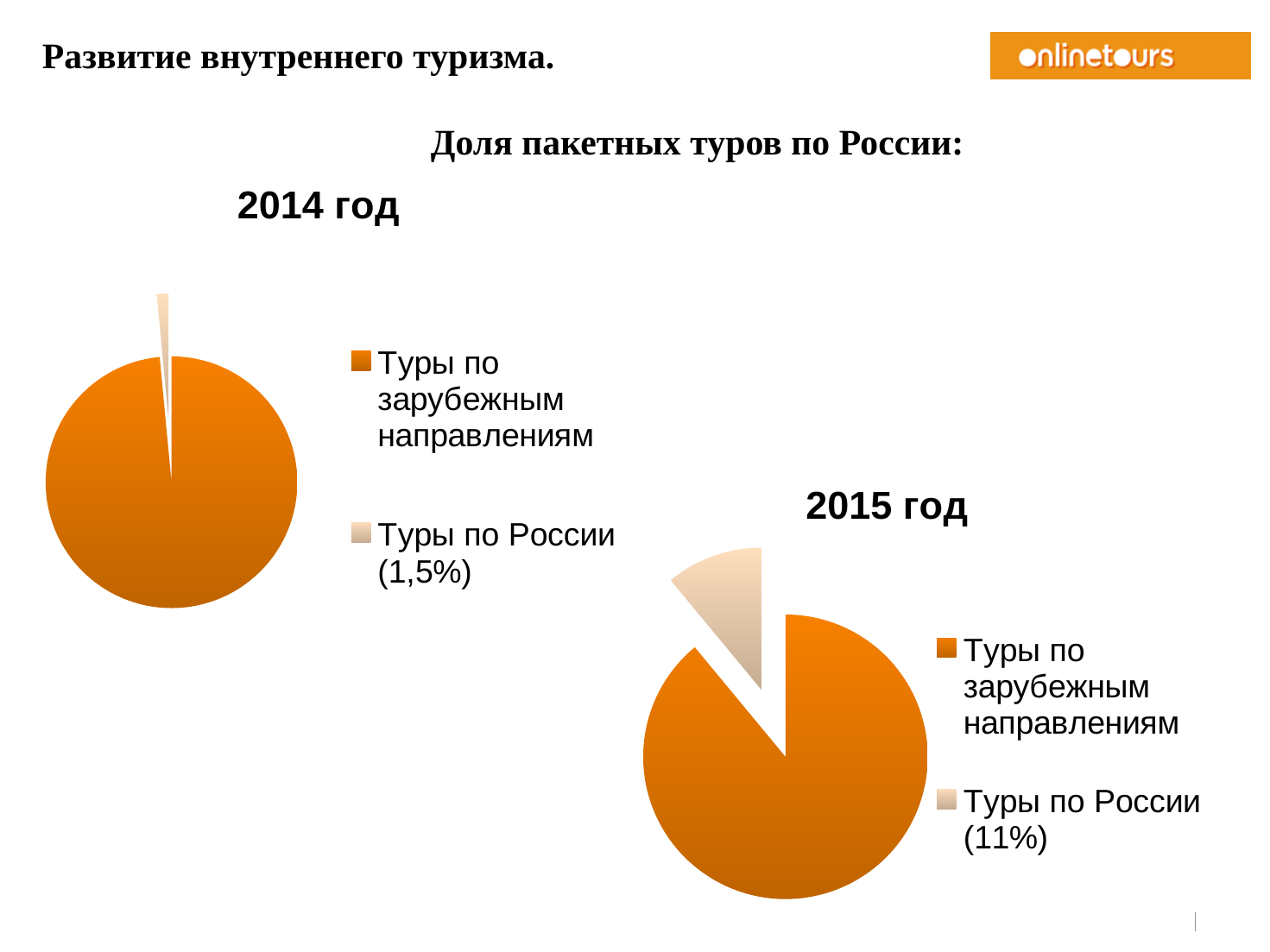
In the "2015 год" chart, which category has the smallest slice? Туры по России How many entries does the legend of the "2015 год" chart list? 2 How many slices does the "2014 год" pie chart have? 2 In the "2015 год" chart, what colour is the "Туры по зарубежным направлениям" slice? orange Did the share of "Туры по России" rise or fall from the 2014 chart to the 2015 chart? rise In the "2014 год" chart, which category has the largest slice? Туры по зарубежным направлениям By how many percentage points did the share of "Туры по России" change from the "2014 год" chart to the "2015 год" chart? 9,5% In the "2015 год" chart, what share do "Туры по России" have? 11% What is the common title shown above the two pie charts? Доля пакетных туров по России: What kind of chart is the "2014 год" chart? pie chart Comparing the two charts, in which year is the share of "Туры по России" larger, 2014 or 2015? 2015 In the "2014 год" chart, what share do "Туры по России" have? 1,5%